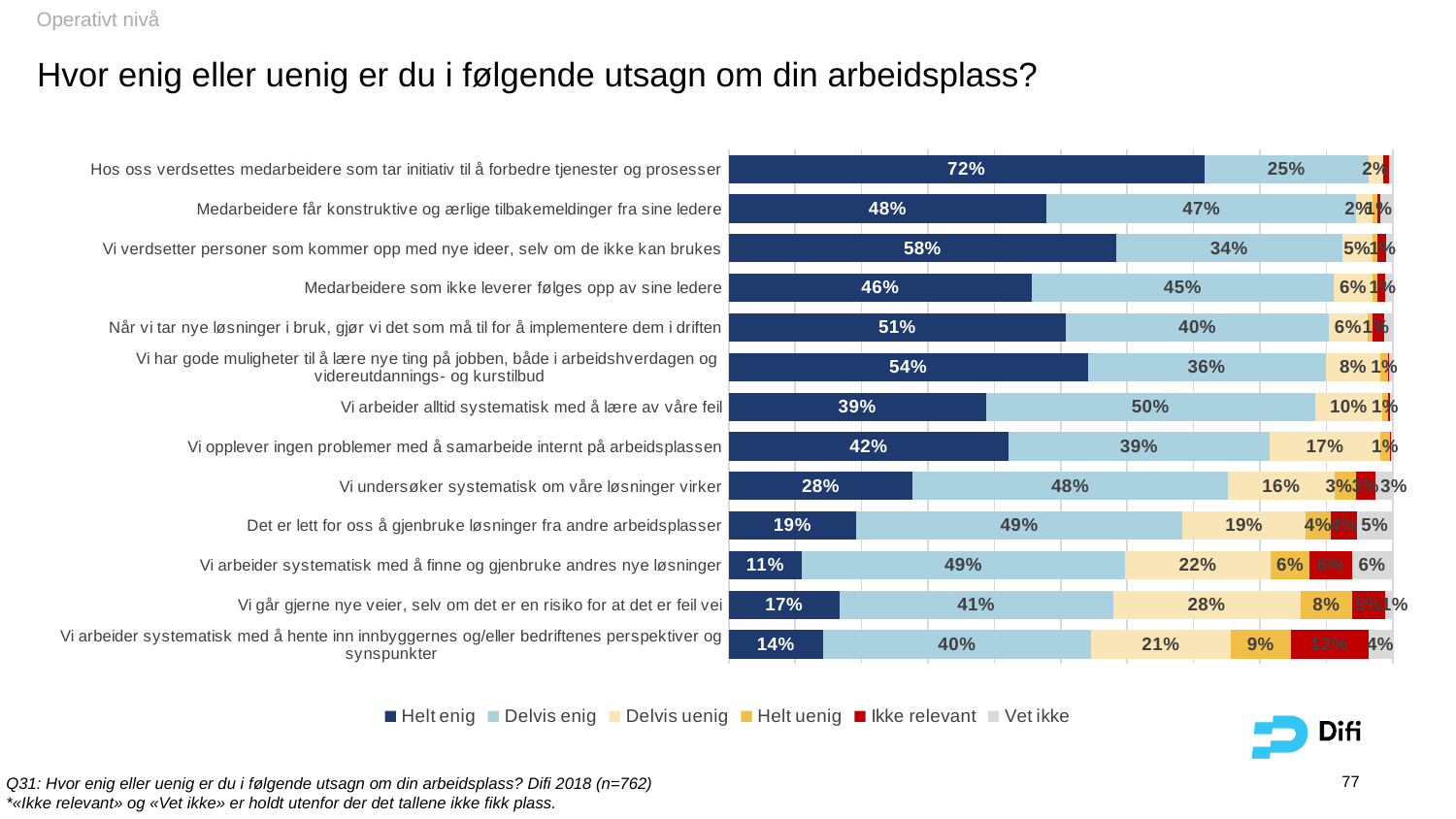
What type of chart is shown on the slide? Stacked bar chart Which statement has the highest 'Helt enig' share? Hos oss verdsettes medarbeidere som tar initiativ til å forbedre tjenester og prosesser What is the 'Helt enig' value for 'Vi undersøker systematisk om våre løsninger virker'? 28% How many statements (categories) are plotted in the chart? 13 How many series does the legend list? 6 What is the 'Delvis enig' value for 'Medarbeidere får konstruktive og ærlige tilbakemeldinger fra sine ledere'? 47% What is the 'Helt enig' value for 'Hos oss verdsettes medarbeidere som tar initiativ til å forbedre tjenester og prosesser'? 72% What is the 'Delvis uenig' value for 'Vi går gjerne nye veier, selv om det er en risiko for at det er feil vei'? 28% For 'Vi arbeider alltid systematisk med å lære av våre feil', which is larger: 'Helt enig' or 'Delvis enig'? Delvis enig What is the first entry in the chart legend? Helt enig What is the difference between the 'Helt enig' and 'Delvis enig' values for 'Hos oss verdsettes medarbeidere som tar initiativ til å forbedre tjenester og prosesser'? 47 percentage points Which statement has the lowest 'Helt enig' share? Vi arbeider systematisk med å finne og gjenbruke andres nye løsninger